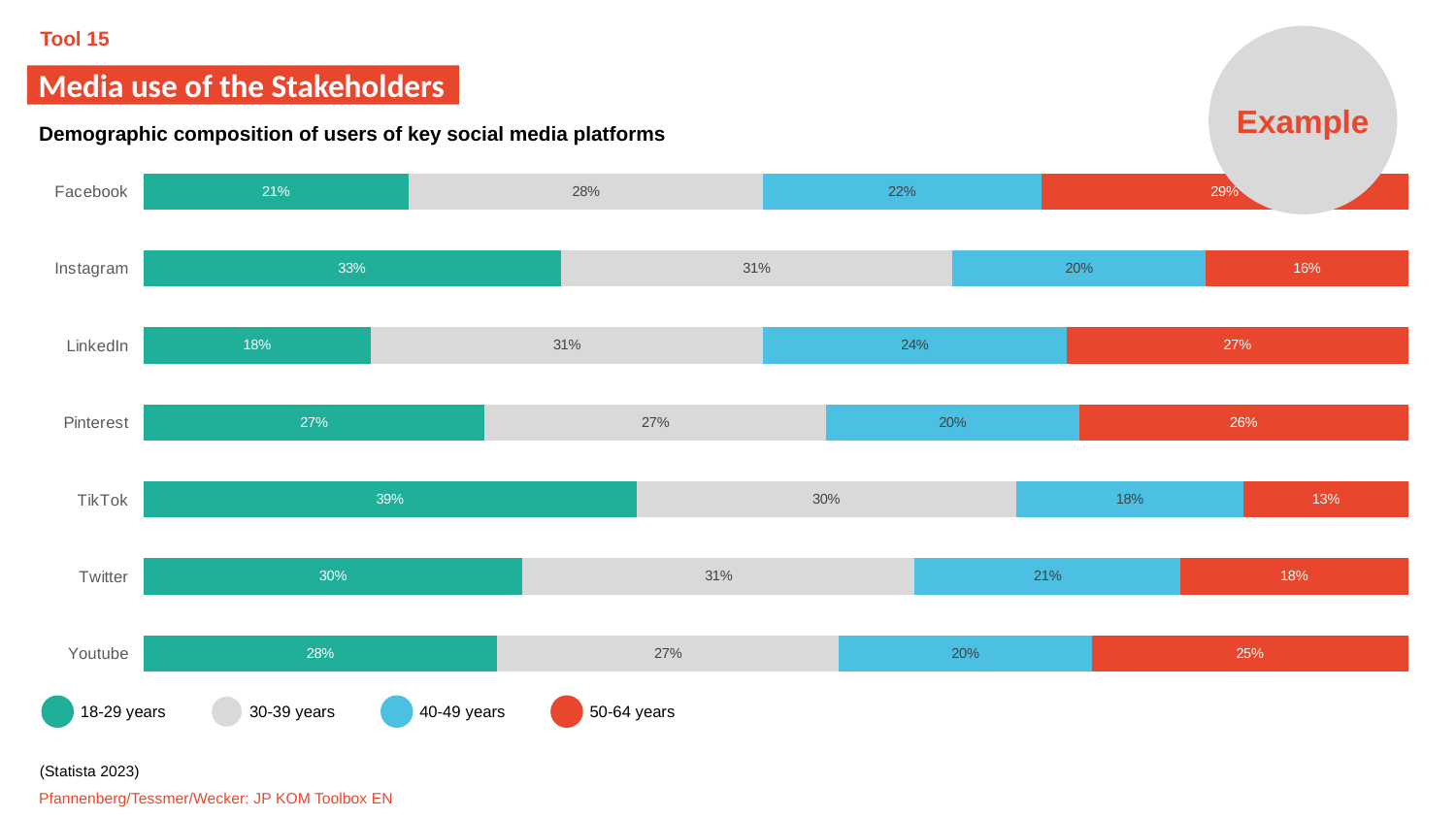
What is the difference between the 18-29 years share for Instagram and for Facebook? 12 percentage points Which platform has the highest share of users aged 18-29 years? TikTok What percentage of TikTok users are aged 18-29 years? 39% Which is larger: the 40-49 years share for LinkedIn or for Pinterest? LinkedIn What kind of chart is shown on the slide? Stacked bar chart Which colour represents the 40-49 years age group in the legend? Light blue What percentage of Facebook users are aged 30-39 years? 28% How many social media platforms are shown in the chart? 7 Which platform has the lowest share of users aged 50-64 years? TikTok What is the total of the Youtube bar across all four age groups? 100% How many age groups does the legend list? 4 What percentage of LinkedIn users are aged 50-64 years? 27%